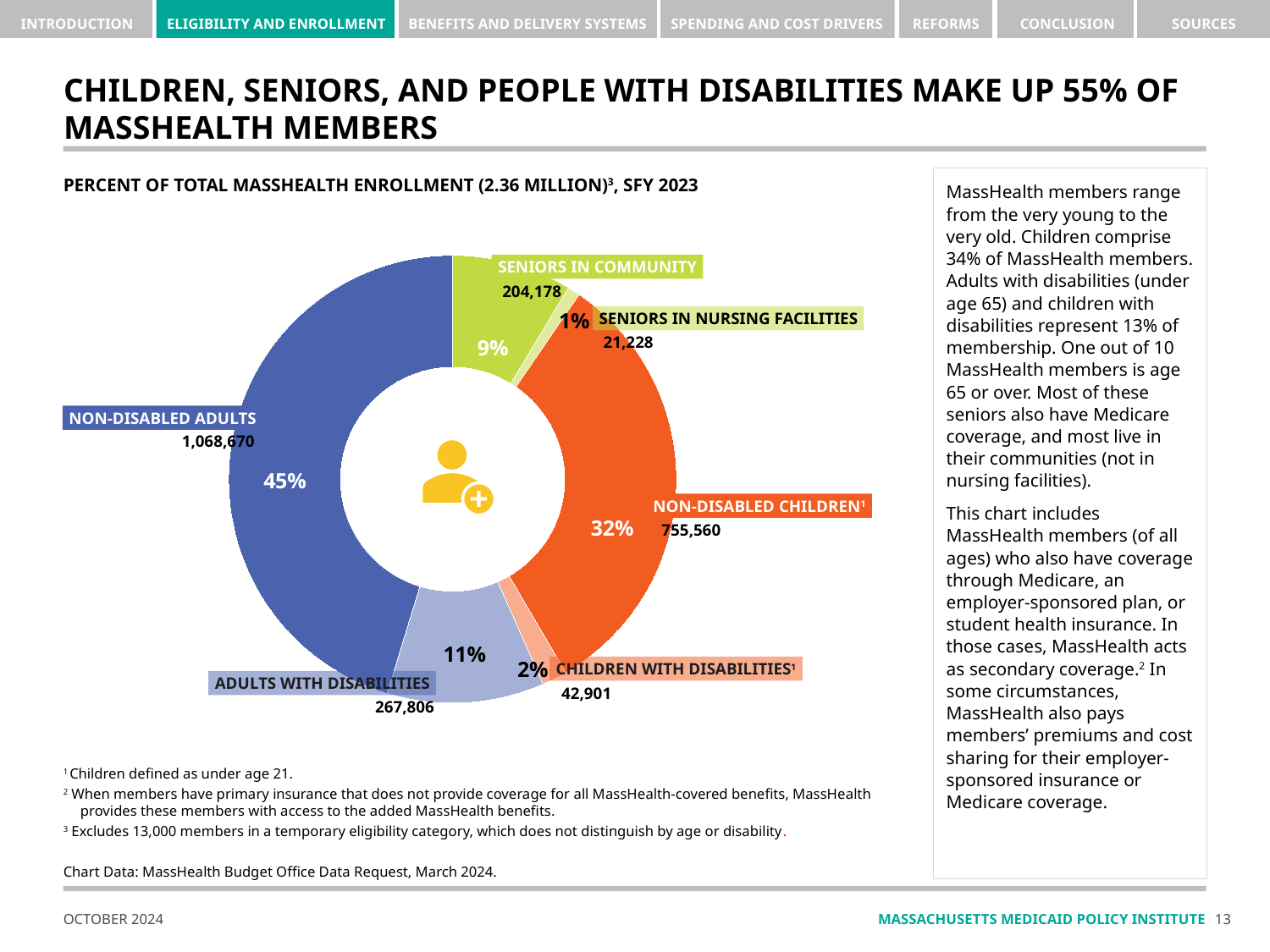
What is the difference in percentage points between non-disabled adults and non-disabled children? 13 percentage points What share of MassHealth enrollment is adults with disabilities? 11% What percent of total MassHealth enrollment is made up of non-disabled adults? 45% How many MassHealth members are seniors in nursing facilities? 21,228 Which category makes up the smallest share of MassHealth enrollment? Seniors in nursing facilities Which category makes up the largest share of MassHealth enrollment? Non-disabled adults Which group has more members: adults with disabilities or children with disabilities? Adults with disabilities How many categories are shown in the chart? 6 What is the title of the chart? Percent of Total MassHealth Enrollment (2.36 Million), SFY 2023 What kind of chart is shown on the slide? Pie chart (donut) What percent of MassHealth enrollment is seniors in the community? 9% How many MassHealth members are non-disabled children? 755,560